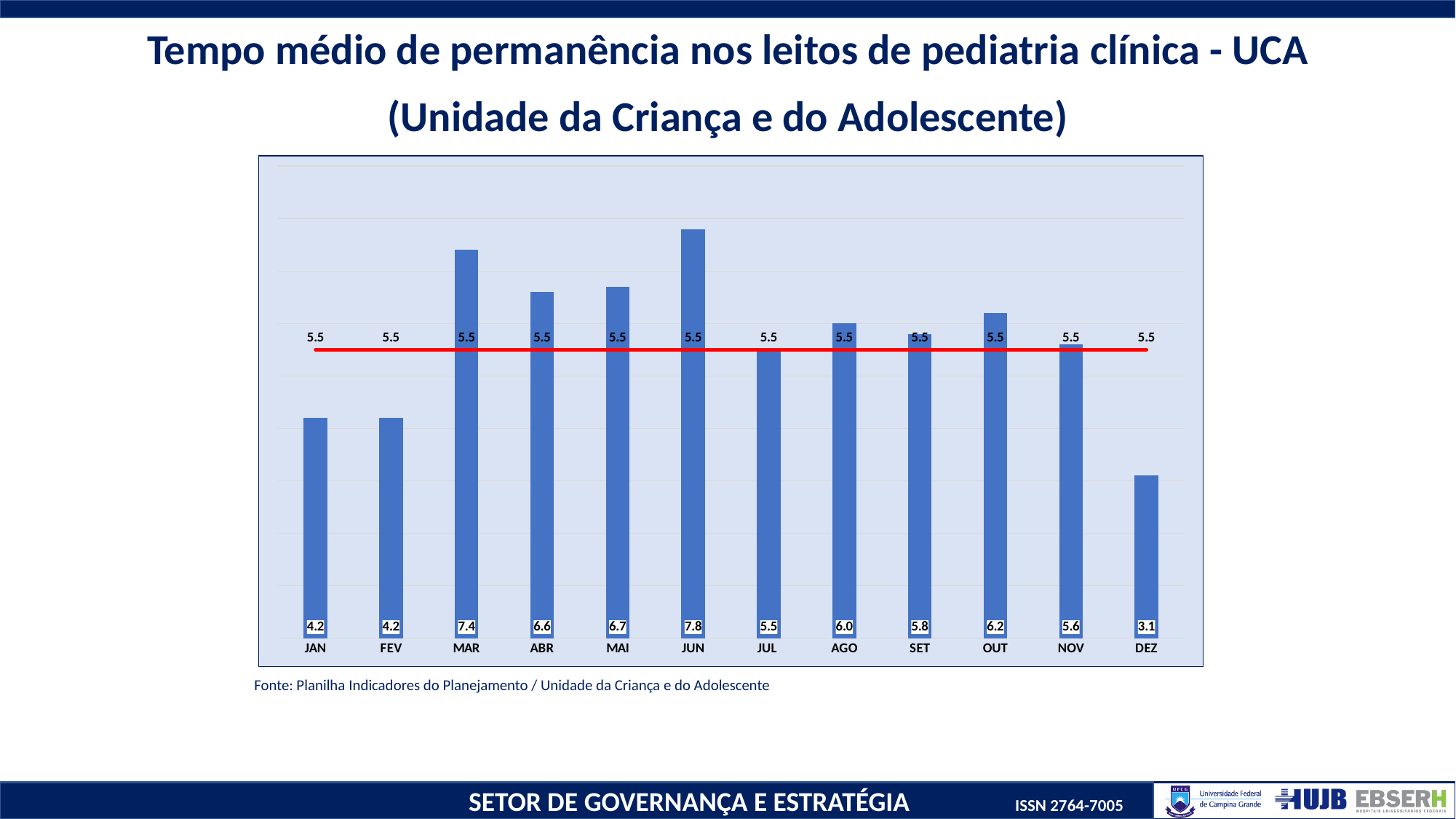
What is the value for AGO? 6.0 What kind of chart is shown? combination bar and line chart What is the value of the red reference line? 5.5 What is the value for MAR? 7.4 Which month has the highest bar? JUN What is the value for DEZ? 3.1 Do the values rise or fall from OUT to DEZ? fall How many months are shown on the x axis? 12 What is the difference between the values for MAR and ABR? 0.8 Which month has the lowest bar? DEZ Which is larger, the value for ABR or the value for MAI? MAI What is the difference between the values for JUN and JAN? 3.6